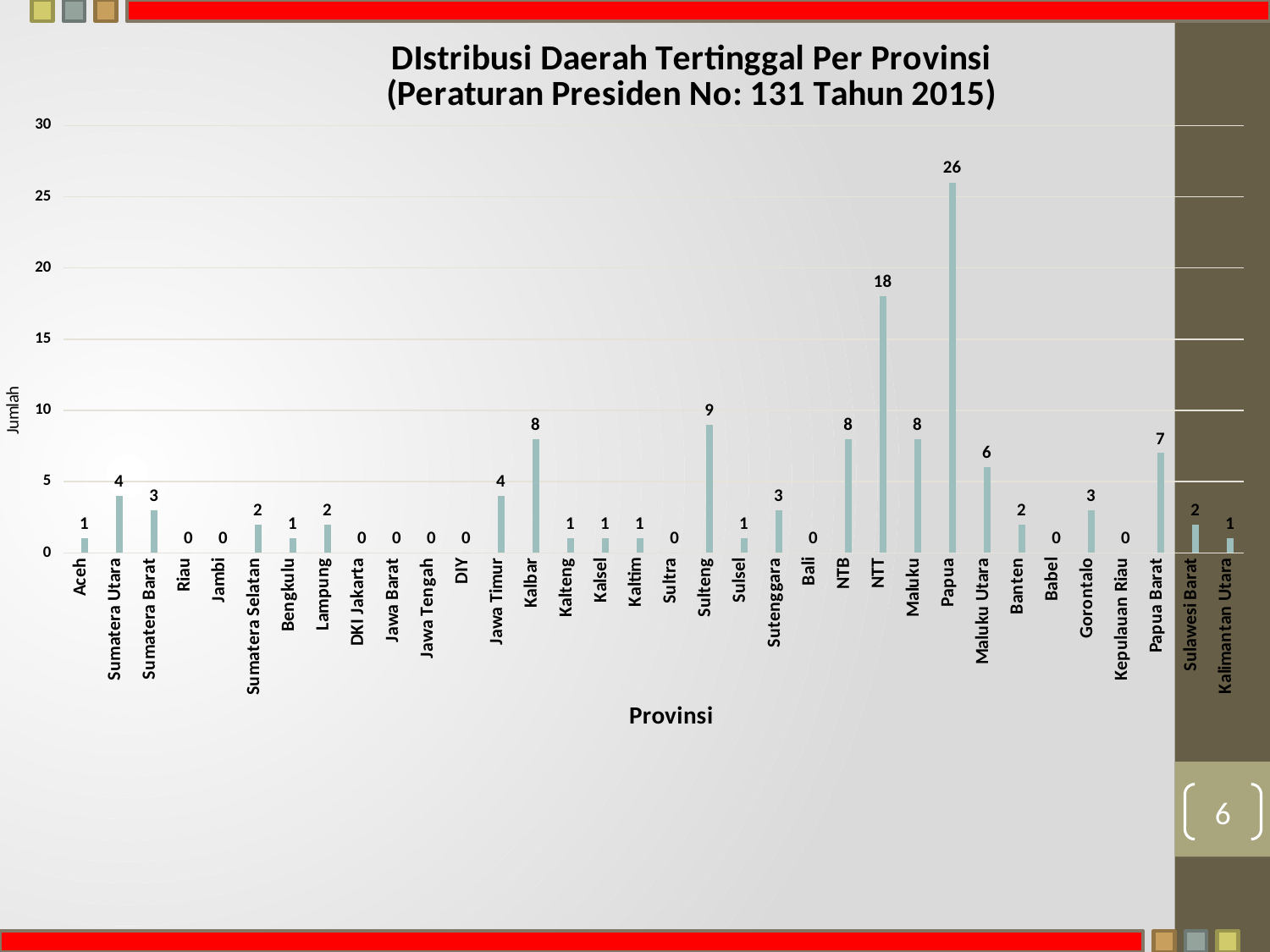
What is the difference between the values for Papua and NTT? 8 What is the label of the y axis? Jumlah How many provinces are shown on the x axis? 34 What is the value for Papua? 26 Which province has the highest value? Papua What is the value for Sulteng? 9 What is the label of the x axis? Provinsi Is the value for NTT greater or less than 15? greater What is the value for NTT? 18 What kind of chart is shown on the slide? Bar chart Which is larger, the value for Kalbar or the value for Papua Barat? Kalbar What is the value for Maluku Utara? 6